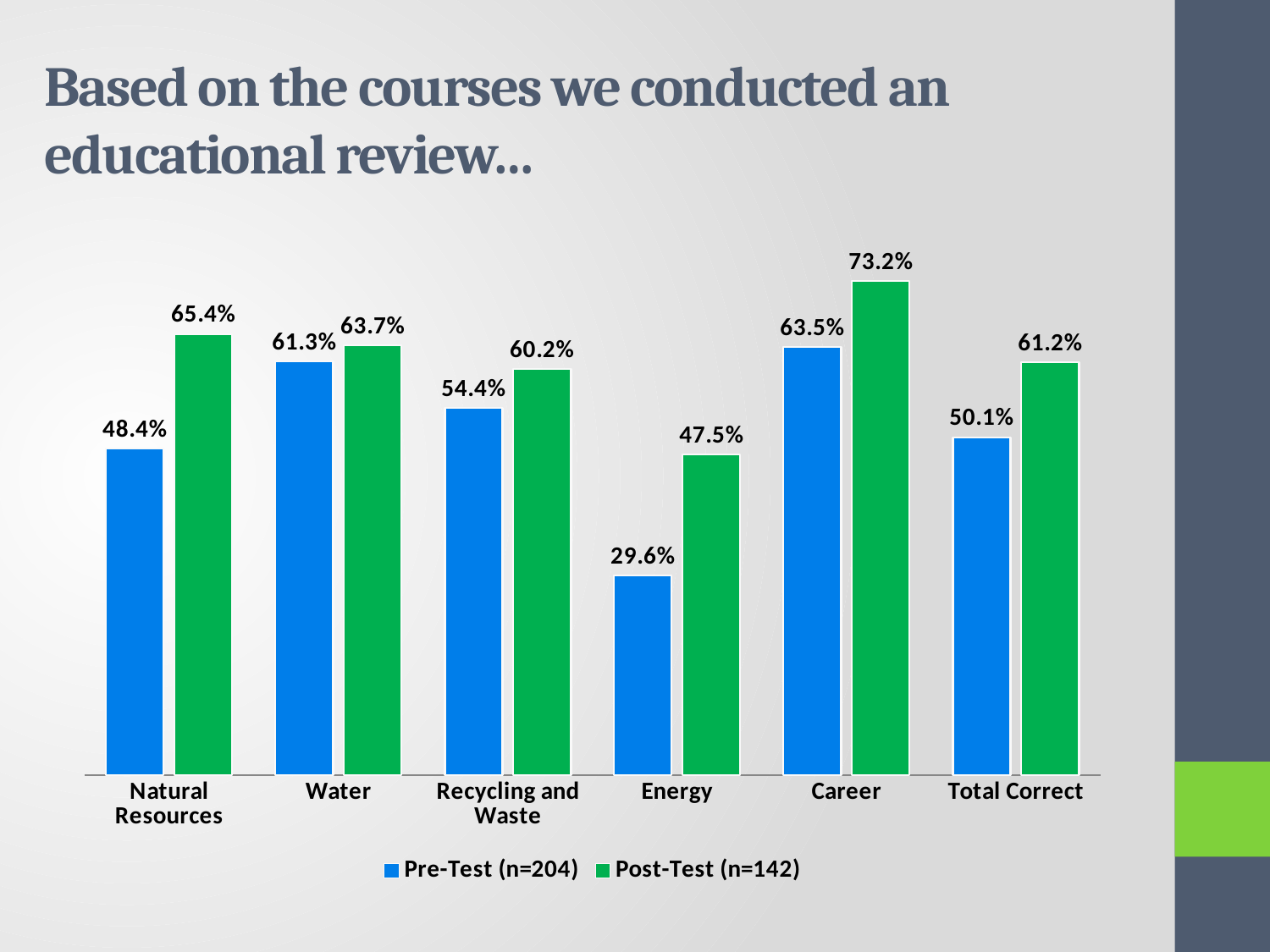
Which is larger: the Pre-Test value for Water or the Pre-Test value for Career? Career Which category has the highest Post-Test (n=142) value? Career What is the difference between the Post-Test and Pre-Test values for Natural Resources? 17.0% What kind of chart is shown on the slide? Bar chart What is the Post-Test (n=142) value for Recycling and Waste? 60.2% How many categories are shown on the x axis? 6 What is the Pre-Test (n=204) value for Total Correct? 50.1% What is the Pre-Test (n=204) value for Energy? 29.6% Which category has the lowest Pre-Test (n=204) value? Energy What is the Post-Test (n=142) value for Career? 73.2% How many series does the legend list? 2 What is the difference between the Post-Test and Pre-Test values for Energy? 17.9%